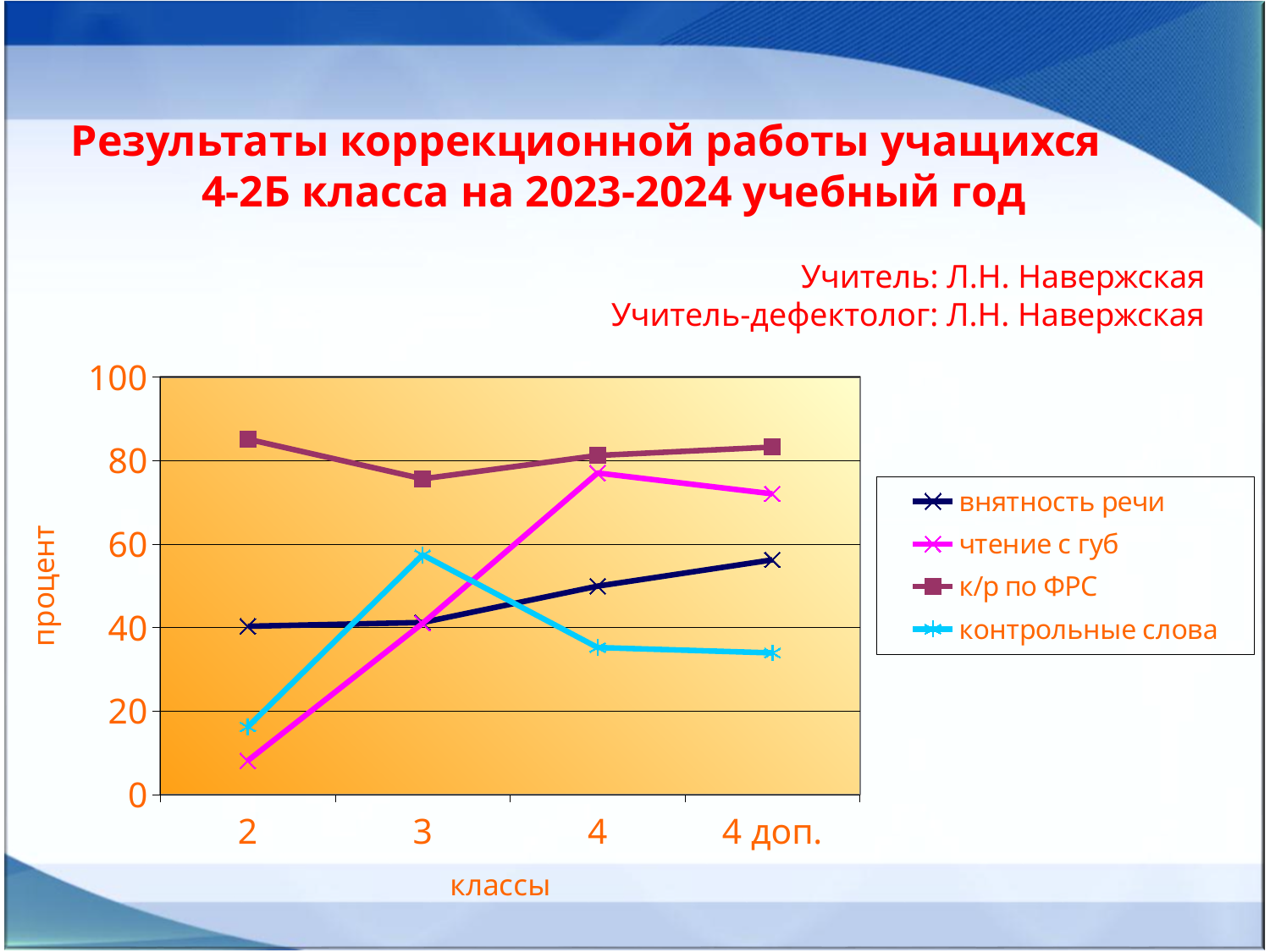
Which is larger at class 4: чтение с губ or внятность речи? чтение с губ Which series has the lowest value at class 2? чтение с губ How many categories are shown on the x axis? 4 Does the внятность речи series rise or fall from class 2 to class 4 доп.? rise Which series has the lowest value at class 4 доп.? контрольные слова What is the label of the y axis? процент Is the value for чтение с губ at class 2 greater or less than 20? less Is the value for к/р по ФРС at class 2 greater or less than 80? greater How many series does the legend list? 4 Is the value for контрольные слова at class 4 greater or less than 40? less What kind of chart is shown on the slide? line chart Which series has the highest value at class 2? к/р по ФРС